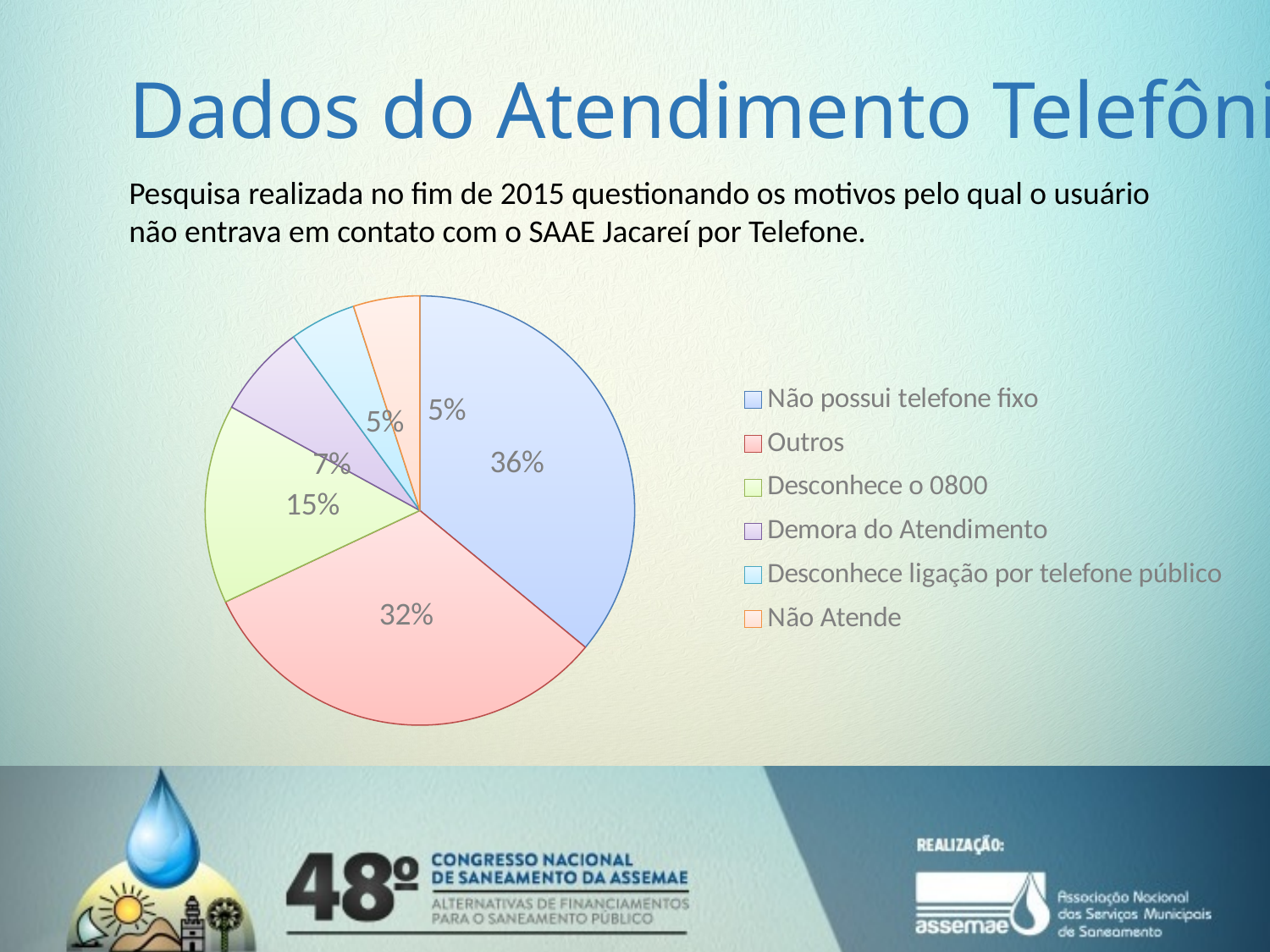
What is the difference in percentage points between "Não possui telefone fixo" and "Outros"? 4 What share of the pie does "Demora do Atendimento" represent? 7% Which is larger, the slice for "Outros" or the slice for "Desconhece o 0800"? Outros Which category has the largest slice of the pie? Não possui telefone fixo What share of the pie does "Não possui telefone fixo" represent? 36% What colour is the slice for "Desconhece o 0800"? light green How many categories does the legend list? 6 What share of the pie does "Outros" represent? 32% What kind of chart is shown on the slide? pie chart What is the difference in percentage points between "Desconhece o 0800" and "Demora do Atendimento"? 8